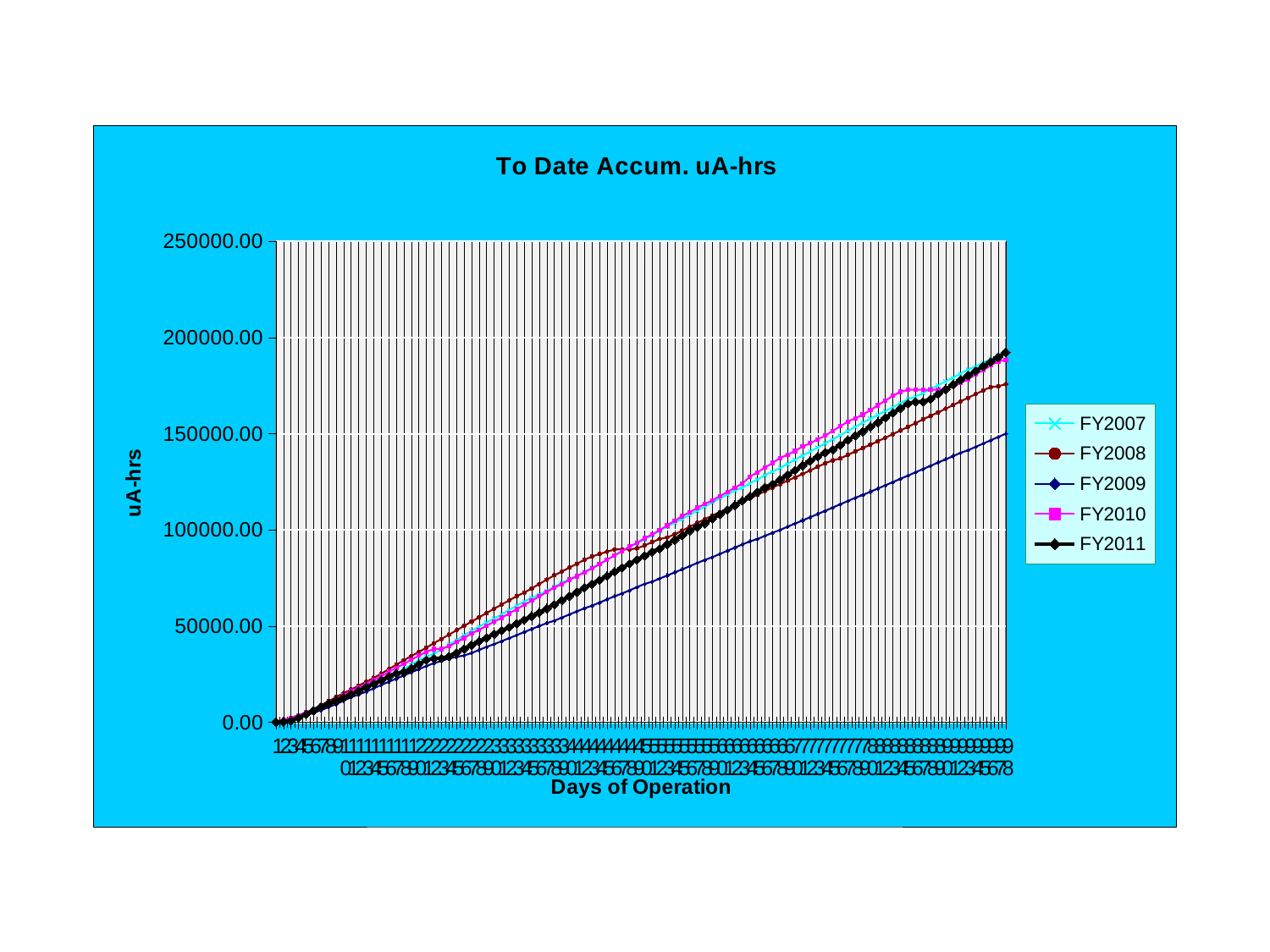
What is the title of the chart? To Date Accum. uA-hrs How many series does the legend list? 5 Is the final value for FY2009 greater or less than 200000.00? less At the last day of operation shown, which is larger: the value for FY2008 or the value for FY2009? FY2008 Which series has the lowest value at the last day of operation shown? FY2009 Is the final value for FY2008 greater or less than 200000.00? less What kind of chart is shown on the slide? line chart Do the values for FY2011 rise or fall as the days of operation increase? rise Is the final value for FY2011 greater or less than 150000.00? greater What is the label of the x axis? Days of Operation At the last day of operation shown, which is larger: the value for FY2009 or the value for FY2011? FY2011